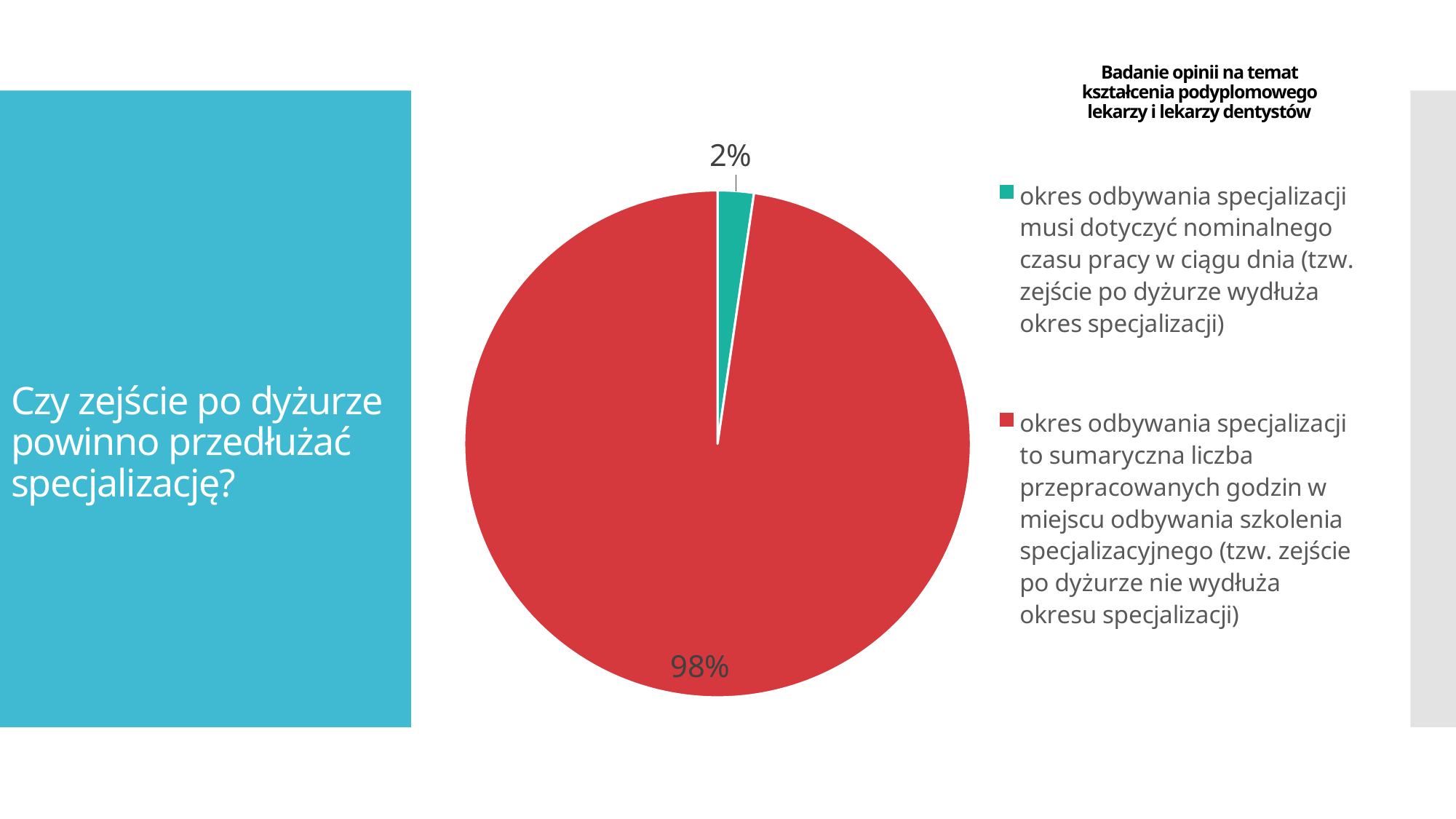
What colour is the slice labelled 98%? red What share of the pie does the slice 'okres odbywania specjalizacji to sumaryczna liczba przepracowanych godzin w miejscu odbywania szkolenia specjalizacyjnego' represent? 98% What is the difference in percentage points between the 98% slice and the 2% slice? 96 percentage points Which is larger: the share for 'zejście po dyżurze wydłuża okres specjalizacji' or the share for 'zejście po dyżurze nie wydłuża okresu specjalizacji'? zejście po dyżurze nie wydłuża okresu specjalizacji What share of the pie does the slice 'okres odbywania specjalizacji musi dotyczyć nominalnego czasu pracy w ciągu dnia' represent? 2% How many entries does the legend list? 2 Which slice of the pie is the largest? okres odbywania specjalizacji to sumaryczna liczba przepracowanych godzin w miejscu odbywania szkolenia specjalizacyjnego (tzw. zejście po dyżurze nie wydłuża okresu specjalizacji) What colour is the slice labelled 2%? green What kind of chart is shown on the slide? pie chart What is the value of the green slice? 2% How many slices does the pie chart have? 2 Which slice of the pie is the smallest? okres odbywania specjalizacji musi dotyczyć nominalnego czasu pracy w ciągu dnia (tzw. zejście po dyżurze wydłuża okres specjalizacji)